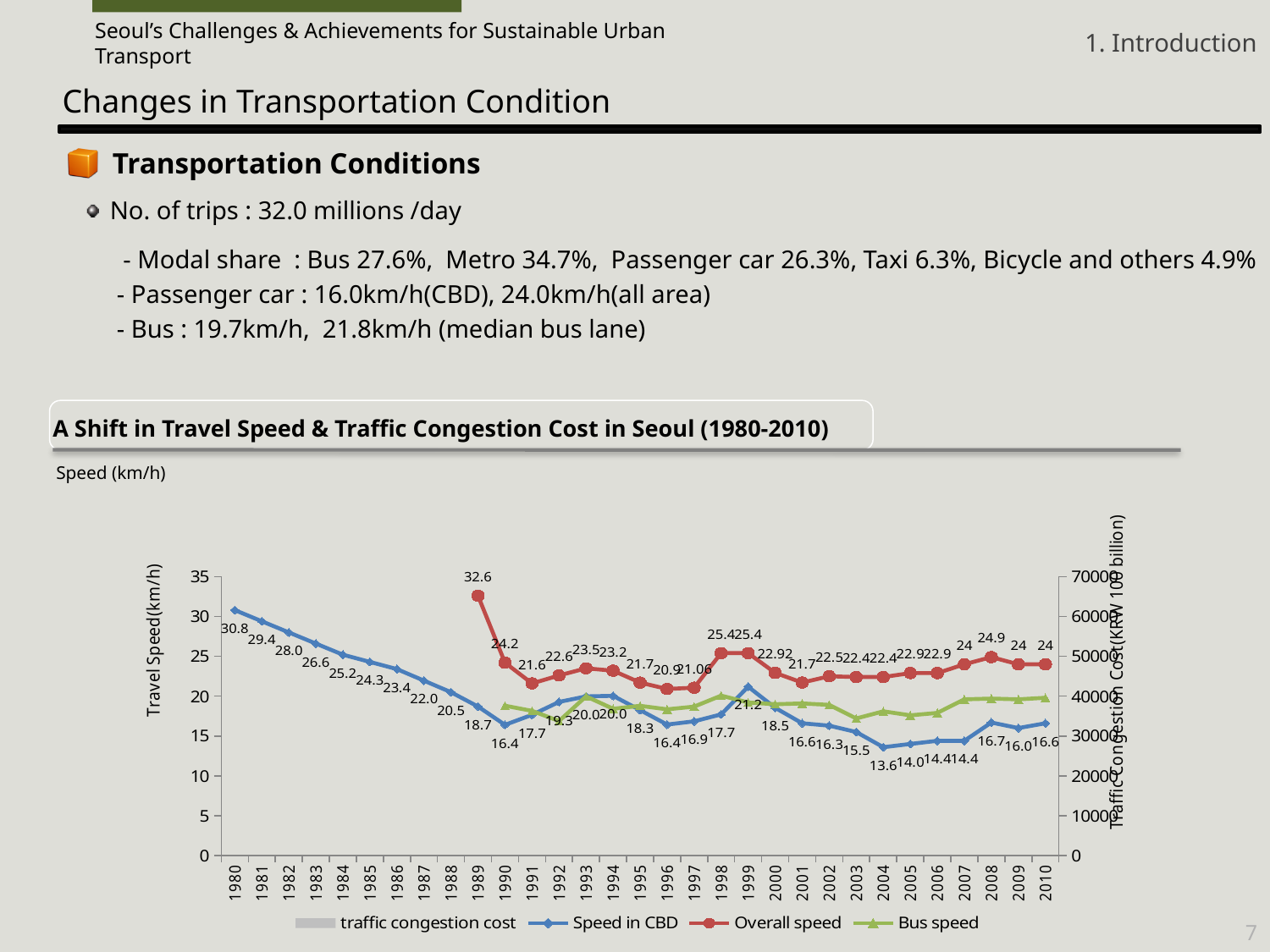
Is the Bus speed value for 2010 greater or less than 15? greater How many years are shown on the x axis of the chart? 31 What kind of chart is shown under 'A Shift in Travel Speed & Traffic Congestion Cost in Seoul (1980-2010)'? line chart What is the difference between the Speed in CBD values for 1980 and 2010? 14.2 What is the Speed in CBD value for 1980? 30.8 How many series does the legend of the chart list? 4 In which year is the Speed in CBD series at its lowest? 2004 What is the Overall speed value for 1989? 32.6 Which is larger in 2008: Overall speed or Speed in CBD? Overall speed In which year is the Overall speed series at its highest? 1989 Does the Speed in CBD series rise or fall from 1980 to 1990? fall What is the Overall speed value for 2010? 24